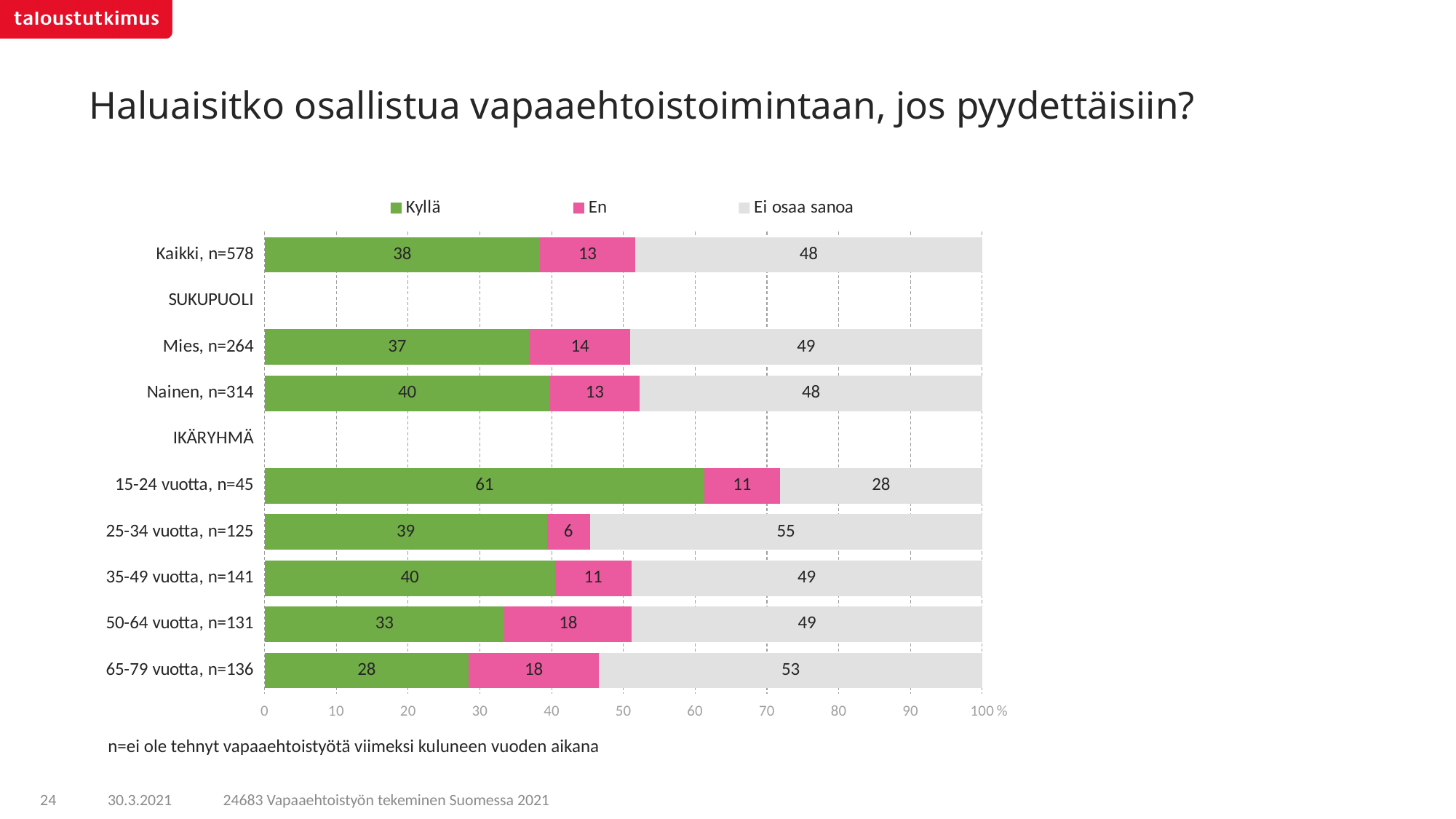
Which category has the lowest Kyllä value? 65-79 vuotta, n=136 How many series does the legend list? 3 What is the difference between the Kyllä value for "15-24 vuotta, n=45" and the Kyllä value for "65-79 vuotta, n=136"? 33 What is the total of the stacked bar for "Kaikki, n=578"? 99 What is the value of the En series for the category "50-64 vuotta, n=131"? 18 What is the value of the Kyllä series for the category "Kaikki, n=578"? 38 What kind of chart is shown on the slide? Stacked bar chart Which category has the lowest En value? 25-34 vuotta, n=125 Which category has the highest Kyllä value? 15-24 vuotta, n=45 Which has the larger Kyllä value, "Mies, n=264" or "Nainen, n=314"? Nainen, n=314 What colour represents the Kyllä series in the chart? Green What is the value of the Ei osaa sanoa series for the category "25-34 vuotta, n=125"? 55